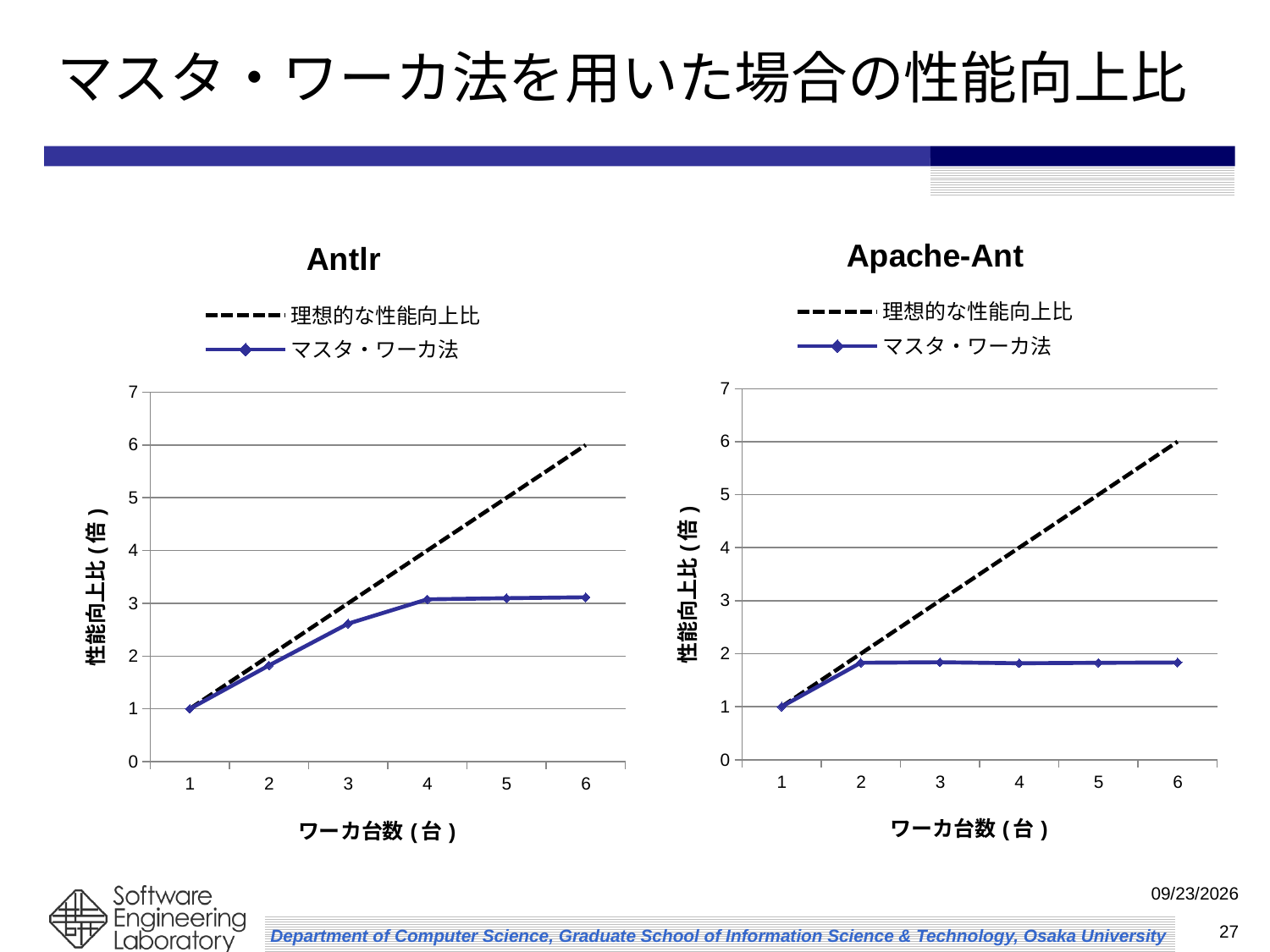
What kind of chart is the Antlr chart? line chart In the Antlr chart, what is the value of 理想的な性能向上比 at 6 workers? 6 In the Apache-Ant chart, what is the value of 理想的な性能向上比 at 1 worker? 1 In the Antlr chart, is the value of マスタ・ワーカ法 at 4 workers greater or less than 2? greater In the Antlr chart, how many worker counts (points) are plotted along the x axis? 6 In the Antlr chart, is the value of マスタ・ワーカ法 at 6 workers greater or less than 4? less In the Antlr chart, which series is higher at 6 workers, 理想的な性能向上比 or マスタ・ワーカ法? 理想的な性能向上比 In the Apache-Ant chart, does the 理想的な性能向上比 series rise or fall as the number of workers increases? rise Which chart shows a higher マスタ・ワーカ法 value at 6 workers, Antlr or Apache-Ant? Antlr In the Apache-Ant chart, is the value of マスタ・ワーカ法 at 6 workers greater or less than 3? less How many series does the legend of the Apache-Ant chart list? 2 What is the x-axis label of the Apache-Ant chart? ワーカ台数 (台)